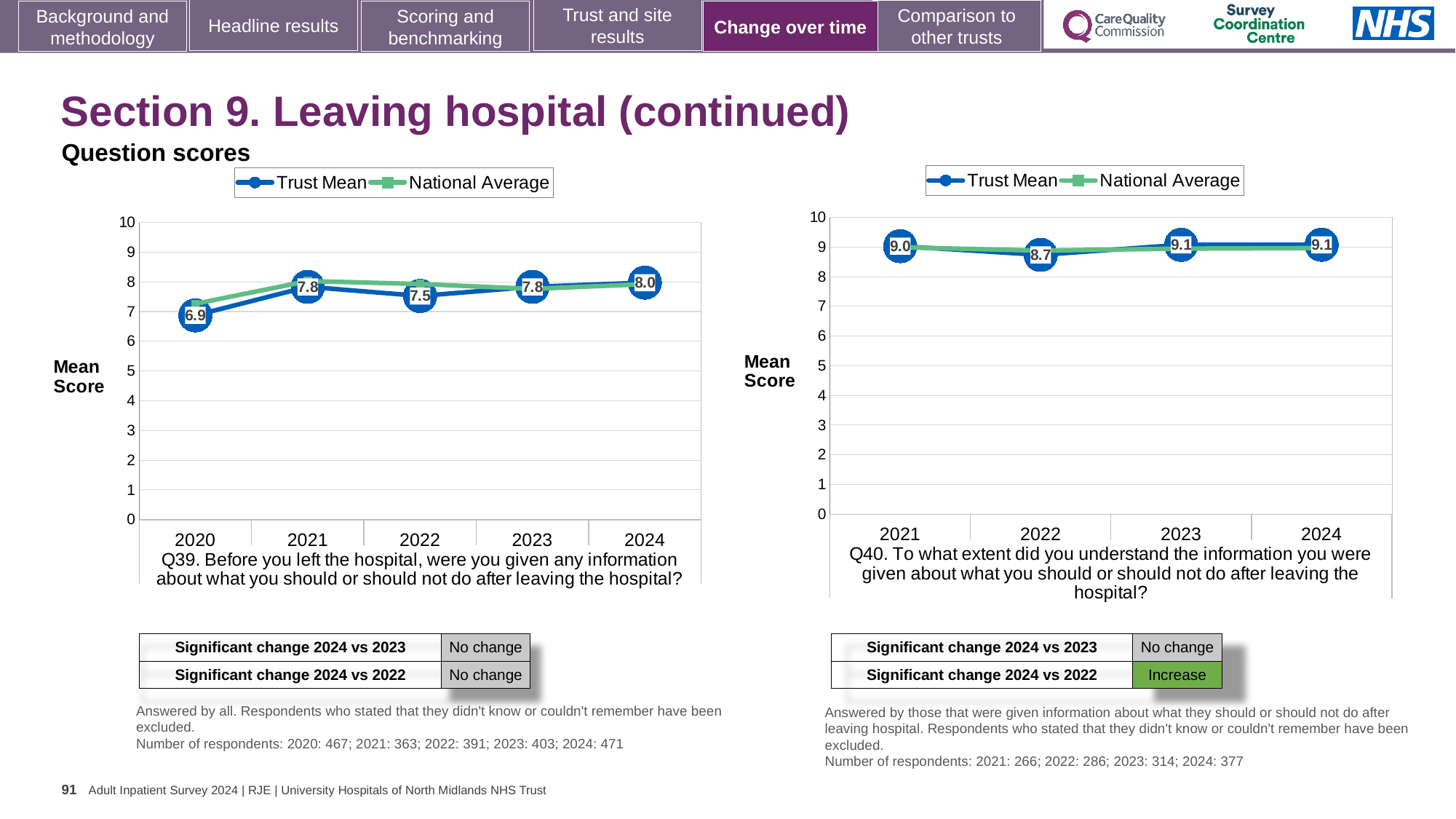
On the Q39 chart (left), is the Trust Mean score for 2022 larger or smaller than the score for 2021? Smaller On the Q40 chart (right), which year has the lowest Trust Mean score? 2022 On the Q40 chart (right), what is the difference between the Trust Mean scores for 2023 and 2022? 0.4 On the Q39 chart (left), what is the difference between the Trust Mean scores for 2024 and 2020? 1.1 On the Q40 chart (right), how many series does the legend list? 2 On the Q39 chart (left), what is the Trust Mean score for 2024? 8.0 On the Q40 chart (right), what is the Trust Mean score for 2022? 8.7 On the Q39 chart (left), which year has the lowest Trust Mean score? 2020 What kind of chart is the Q39 chart on the left? Line chart On the Q39 chart (left), what is the Trust Mean score for 2020? 6.9 On the Q39 chart (left), how many years are shown on the x axis? 5 On the Q40 chart (right), is the Trust Mean score for 2021 greater or less than 8? greater